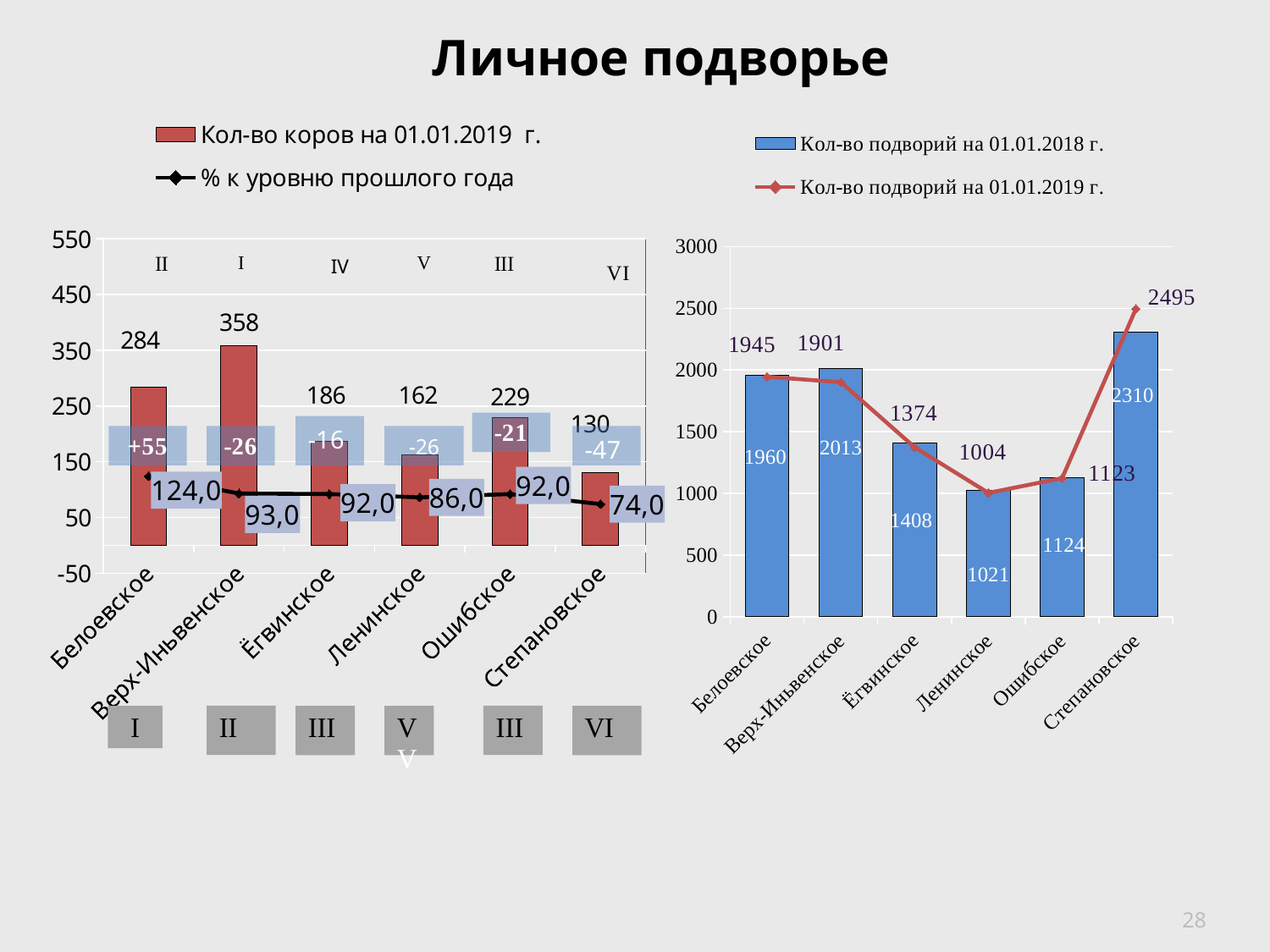
In the left chart, which category has the highest number of cows on 01.01.2019? Верх-Иньвенское In the right chart, what is the Кол-во подворий на 01.01.2019 г. value for Степановское? 2495 In the left chart, how many cows (Кол-во коров на 01.01.2019) are shown for Верх-Иньвенское? 358 How many series does the legend of the right chart list? 2 In the left chart, what is the difference in the number of cows between Верх-Иньвенское and Белоевское? 74 In the left chart, what is the % к уровню прошлого года value for Белоевское? 124,0 In the right chart, what is the difference between the 2019 and 2018 number of households for Степановское? 185 In the right chart, what is the Кол-во подворий на 01.01.2018 г. value for Ленинское? 1021 In the left chart, which has more cows on 01.01.2019: Ёгвинское or Ошибское? Ошибское In the left chart, which category has the lowest number of cows on 01.01.2019? Степановское In the right chart, which category has the highest Кол-во подворий на 01.01.2019 г.? Степановское How many categories are shown on the x axis of the right chart? 6